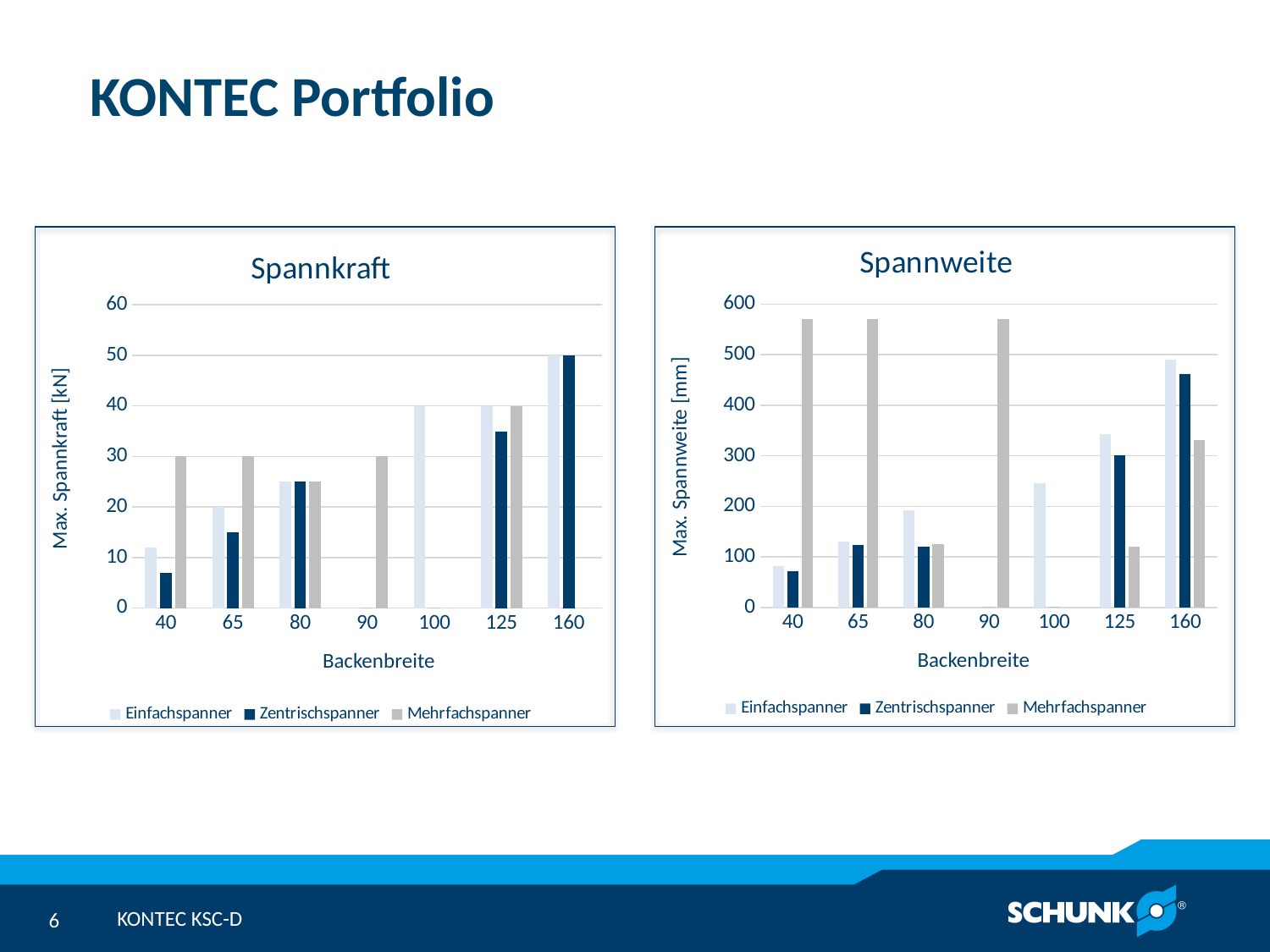
In the Spannweite chart, is the value for Mehrfachspanner at Backenbreite 40 greater or less than 500? greater How many series does the legend of the Spannweite chart list? 3 In the Spannkraft chart, is the value for Zentrischspanner at Backenbreite 40 greater or less than 10? less In the Spannkraft chart, what is the value for Einfachspanner at Backenbreite 100? 40 In the Spannkraft chart, at Backenbreite 40, which is larger: Einfachspanner or Zentrischspanner? Einfachspanner How many Backenbreite categories are shown on the x axis of the Spannkraft chart? 7 In the Spannweite chart, at Backenbreite 80, which is larger: Einfachspanner or Zentrischspanner? Einfachspanner In the Spannweite chart, at which Backenbreite is the Einfachspanner value highest? 160 In the Spannkraft chart, what is the value for Mehrfachspanner at Backenbreite 40? 30 In the Spannkraft chart, what is the value for Einfachspanner at Backenbreite 160? 50 In the Spannweite chart, is the value for Zentrischspanner at Backenbreite 40 greater or less than 100? less